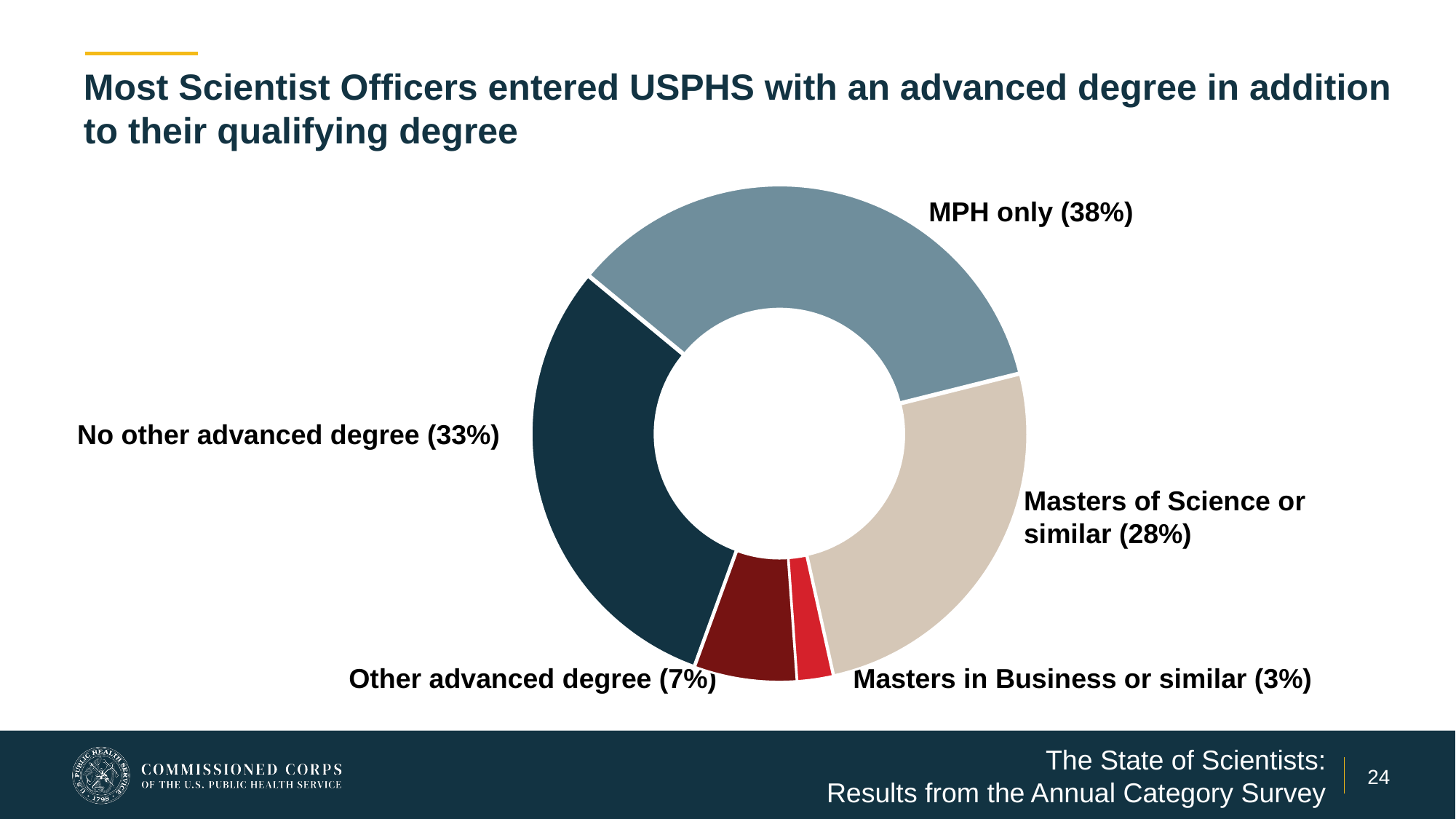
What kind of chart is shown on the slide? Pie chart (donut) Which is larger: the share for Masters of Science or similar, or the share for No other advanced degree? No other advanced degree Which category has the largest share of the chart? MPH only Which category has the smallest share of the chart? Masters in Business or similar What percentage of Scientist Officers had no other advanced degree? 33% How many categories are shown in the chart? 5 What share of Scientist Officers entered USPHS with an MPH only? 38% What is the difference in percentage points between Other advanced degree and Masters in Business or similar? 4 What share of Scientist Officers had a Masters of Science or similar? 28% What is the difference in percentage points between MPH only and No other advanced degree? 5 What is the combined share of MPH only and Masters of Science or similar? 66% What percentage of Scientist Officers had a Masters in Business or similar? 3%